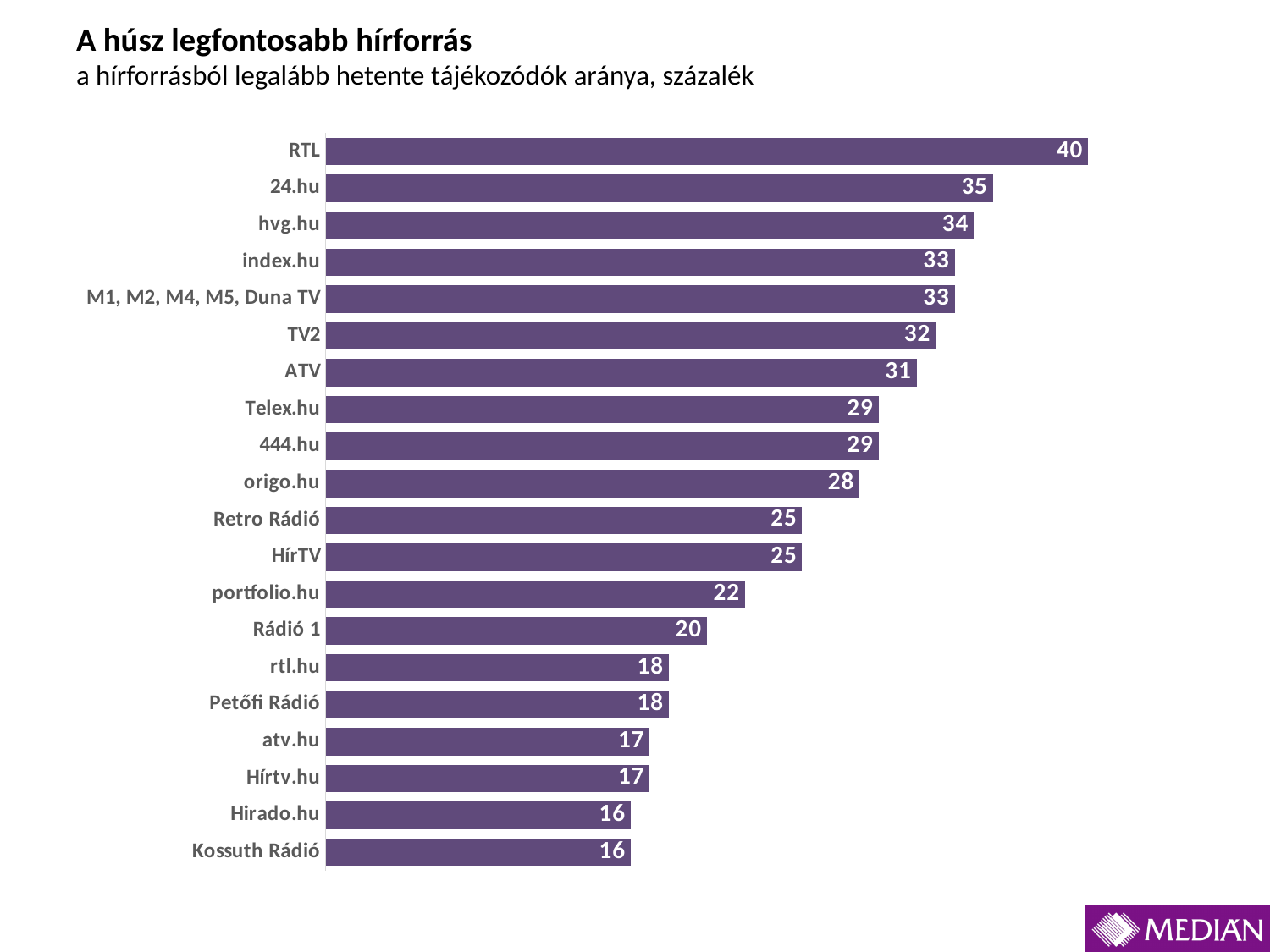
What is the title of the chart? A húsz legfontosabb hírforrás Which has a larger value, portfolio.hu or origo.hu? origo.hu Which news source has the highest value? RTL Which has a larger value, TV2 or ATV? TV2 What is the difference between the values for RTL and Rádió 1? 20 What is the value for Kossuth Rádió? 16 How many news sources are shown in the chart? 20 What kind of chart is shown on the slide? bar chart What is the value for RTL? 40 What is the difference between the values for 24.hu and hvg.hu? 1 What is the value for M1, M2, M4, M5, Duna TV? 33 What is the value for Telex.hu? 29